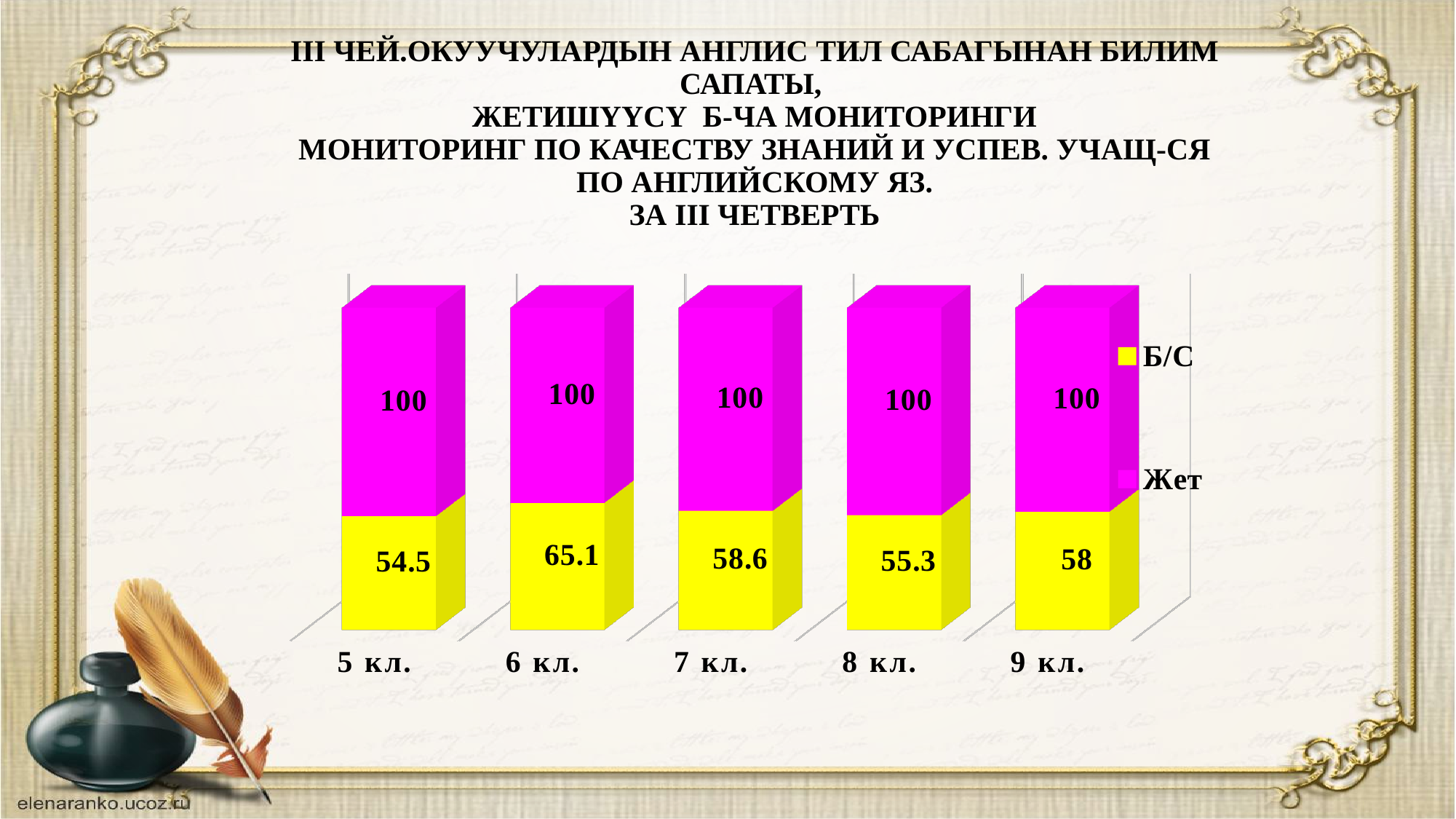
Which has a larger Б/С value, 7 кл. or 8 кл.? 7 кл. What is the Жет value for 7 кл.? 100 Which class has the highest Б/С value? 6 кл. What is the Б/С value for 8 кл.? 55.3 What kind of chart is shown on the slide? Stacked bar chart Which class has the lowest Б/С value? 5 кл. How many classes are shown on the x axis? 5 What is the difference between the Б/С values for 6 кл. and 5 кл.? 10.6 What is the Б/С value for 6 кл.? 65.1 What is the Б/С value for 9 кл.? 58 What is the total of the stacked bar for 9 кл.? 158 How many series does the legend list? 2